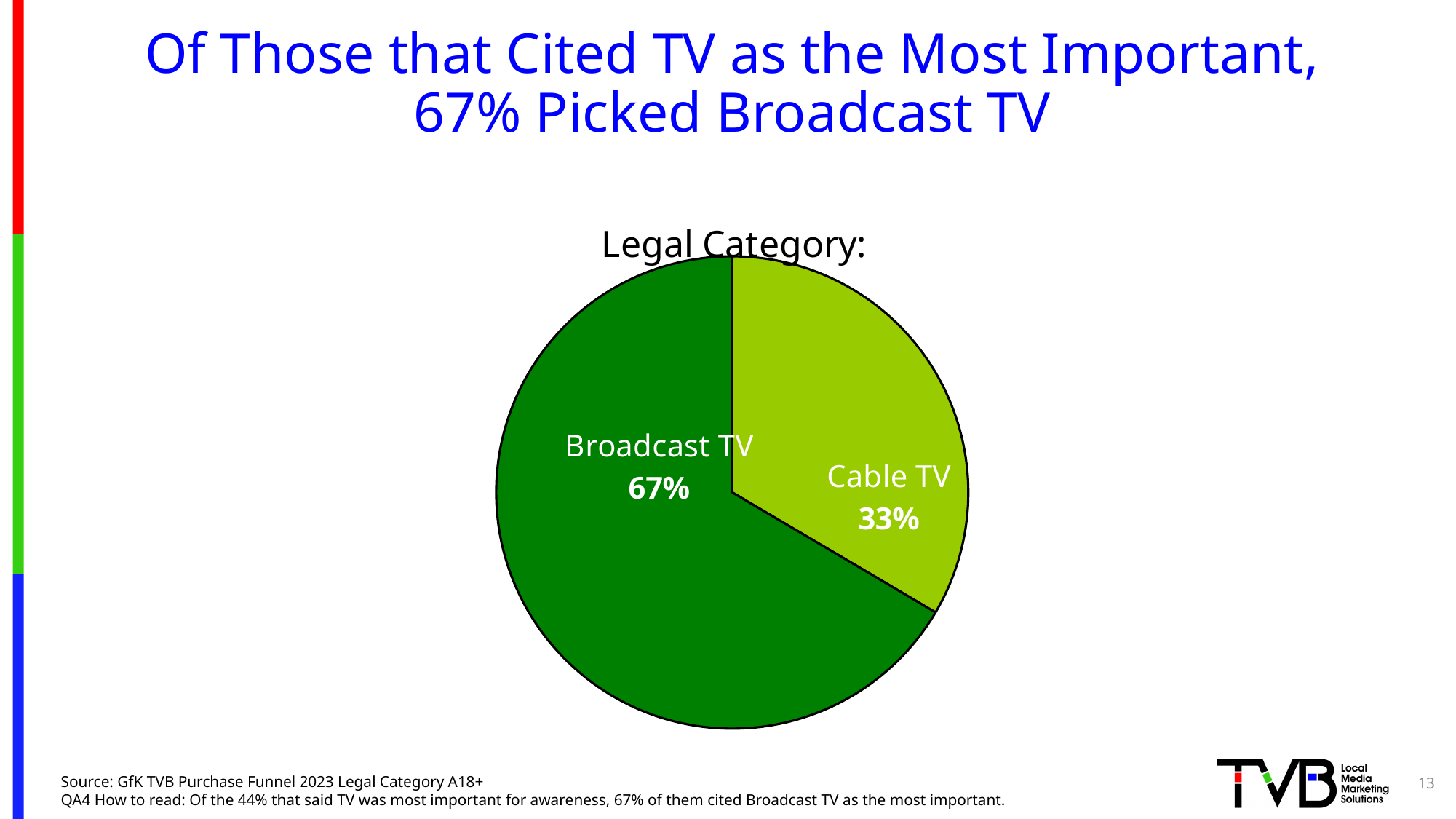
Which slice of the pie is the largest? Broadcast TV Which slice is shown in the lighter green colour? Cable TV What share of the pie does Cable TV hold? 33% Is the value for Broadcast TV greater or less than 50%? greater What is the title of the chart? Legal Category: What is the difference in percentage points between the Broadcast TV and Cable TV slices? 34 What share of the pie does Broadcast TV hold? 67% Which is larger, the Broadcast TV slice or the Cable TV slice? Broadcast TV Is the value for Cable TV greater or less than 50%? less What kind of chart is shown on the slide? Pie chart Which slice of the pie is the smallest? Cable TV How many slices does the pie chart have? 2